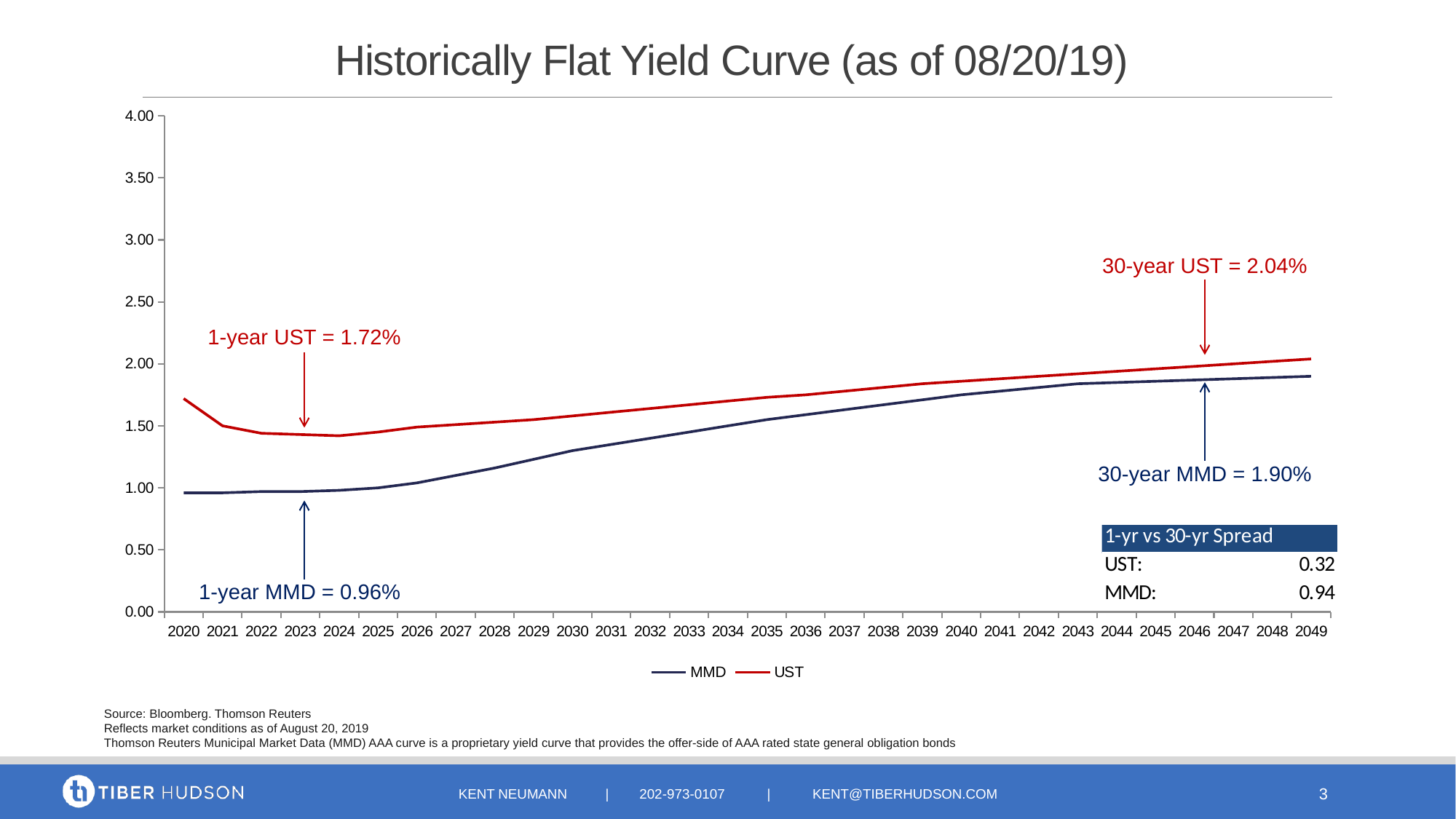
How many years are labelled on the x axis? 30 According to the 1-yr vs 30-yr Spread table, what is the UST spread? 0.32 According to the 1-yr vs 30-yr Spread table, what is the MMD spread? 0.94 Is the MMD value at 2030 greater or less than 1.50? less How many series does the legend list? 2 What is the 30-year UST yield shown on the chart? 2.04% Does the MMD line rise or fall from 2025 to 2049? rise At 2049, which series is higher, UST or MMD? UST What is the 1-year UST yield shown on the chart? 1.72% What kind of chart is shown on the slide? line chart What is the 30-year MMD yield shown on the chart? 1.90% What is the 1-year MMD yield shown on the chart? 0.96%